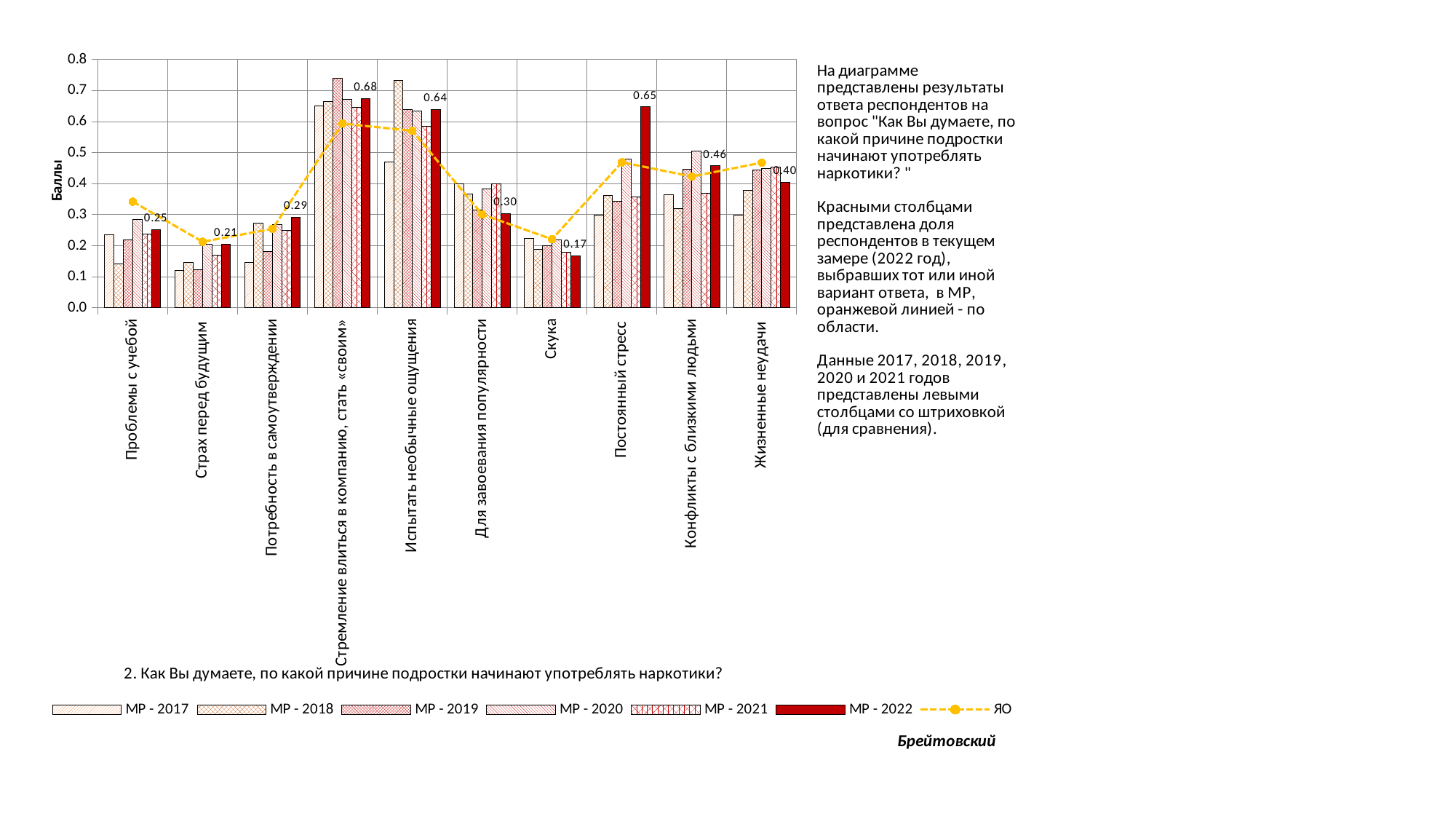
How many categories are shown on the x axis? 10 Is the ЯО value for «Проблемы с учебой» greater or less than 0.3? greater Is the ЯО value for «Стремление влиться в компанию, стать «своим»» greater or less than 0.5? greater What is the МР - 2022 value for «Стремление влиться в компанию, стать «своим»»? 0.68 Which series is drawn as a dashed line rather than bars? ЯО What is the difference between the МР - 2022 values for «Стремление влиться в компанию, стать «своим»» and «Скука»? 0.51 Which category has the highest МР - 2022 value? Стремление влиться в компанию, стать «своим» What is the МР - 2022 value for «Постоянный стресс»? 0.65 Which category has the lowest МР - 2022 value? Скука What is the МР - 2022 value for «Скука»? 0.17 Which has the larger МР - 2022 value: «Конфликты с близкими людьми» or «Жизненные неудачи»? Конфликты с близкими людьми How many series does the legend list? 7